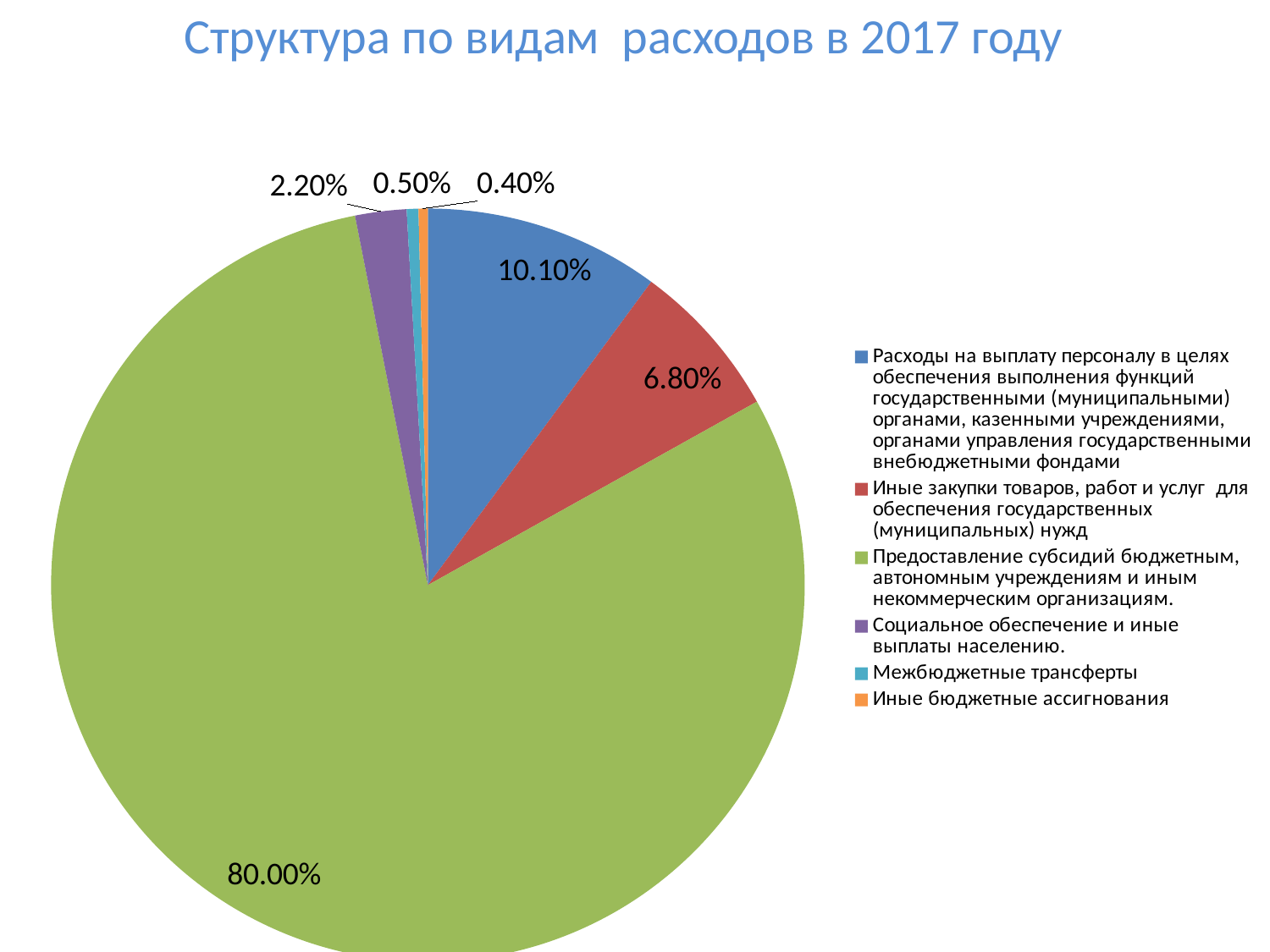
What is the value shown for 'Межбюджетные трансферты'? 0.50% What share of the pie is 'Предоставление субсидий бюджетным, автономным учреждениям и иным некоммерческим организациям'? 80.00% What is the value shown for 'Расходы на выплату персоналу в целях обеспечения выполнения функций государственными (муниципальными) органами, казенными учреждениями, органами управления государственными внебюджетными фондами'? 10.10% What kind of chart is shown on the slide? Pie chart What is the value shown for 'Социальное обеспечение и иные выплаты населению'? 2.20% Which is larger: the share for 'Социальное обеспечение и иные выплаты населению' or the share for 'Межбюджетные трансферты'? Социальное обеспечение и иные выплаты населению Which category has the largest share of the pie? Предоставление субсидий бюджетным, автономным учреждениям и иным некоммерческим организациям What is the difference between the shares of 'Расходы на выплату персоналу...' (10.10%) and 'Иные закупки товаров, работ и услуг...' (6.80%)? 3.30% What is the value shown for 'Иные закупки товаров, работ и услуг для обеспечения государственных (муниципальных) нужд'? 6.80% What is the title of the chart? Структура по видам расходов в 2017 году How many slices does the pie chart have? 6 Which category has the smallest share of the pie? Иные бюджетные ассигнования